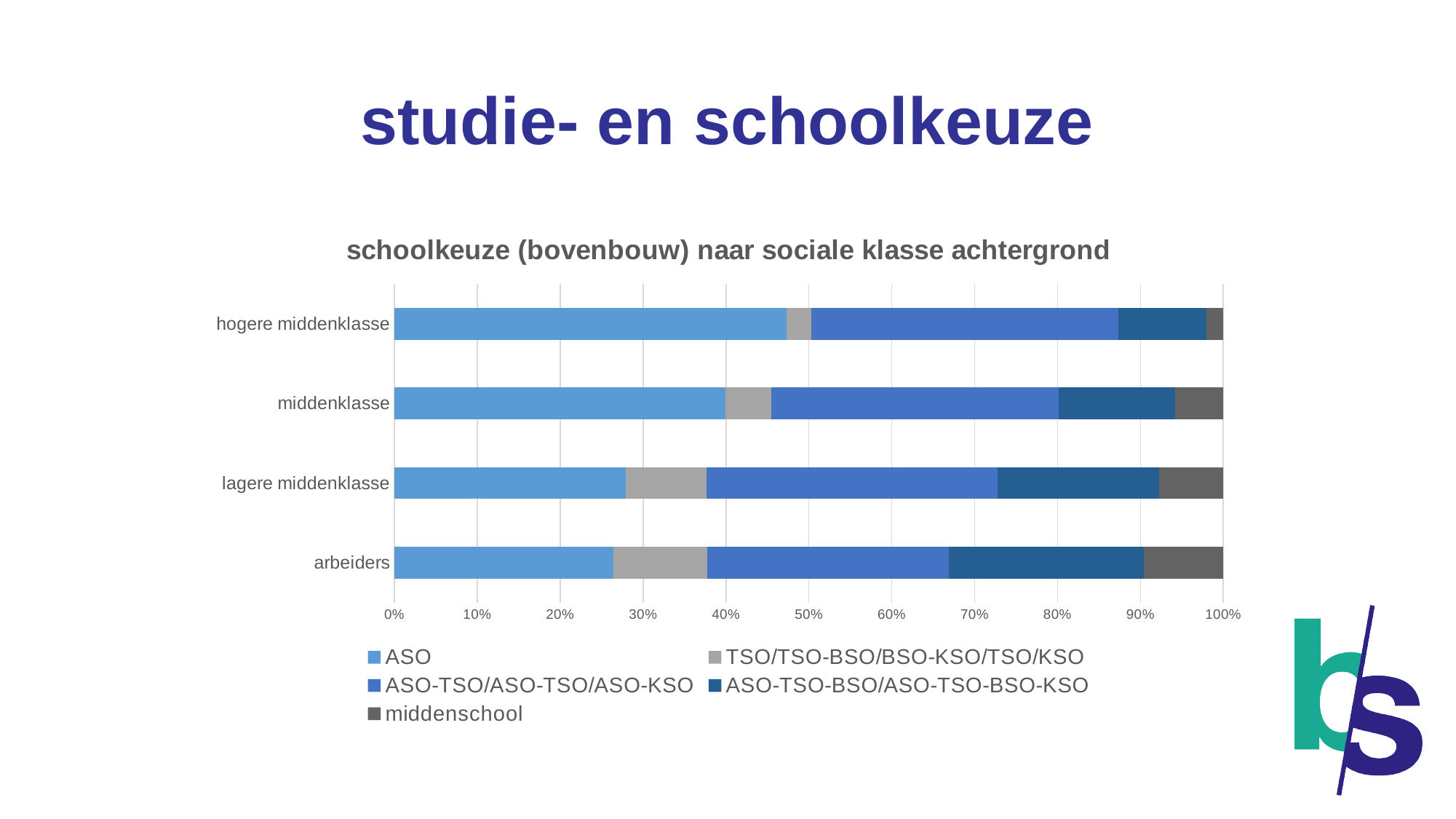
Is the ASO share for lagere middenklasse greater or less than 40%? less How many series does the legend list? 5 Which has a larger middenschool share: middenklasse or hogere middenklasse? middenklasse What kind of chart is shown on the slide? stacked bar chart Which has a larger ASO share: hogere middenklasse or arbeiders? hogere middenklasse What is the title of the chart? schoolkeuze (bovenbouw) naar sociale klasse achtergrond Which social class has the largest ASO share? hogere middenklasse Which series is shown in light blue in the legend? ASO How many social class categories are shown on the chart? 4 Is the ASO share for arbeiders greater or less than 30%? less Which social class has the smallest middenschool share? hogere middenklasse Is the ASO share for hogere middenklasse greater or less than 40%? greater